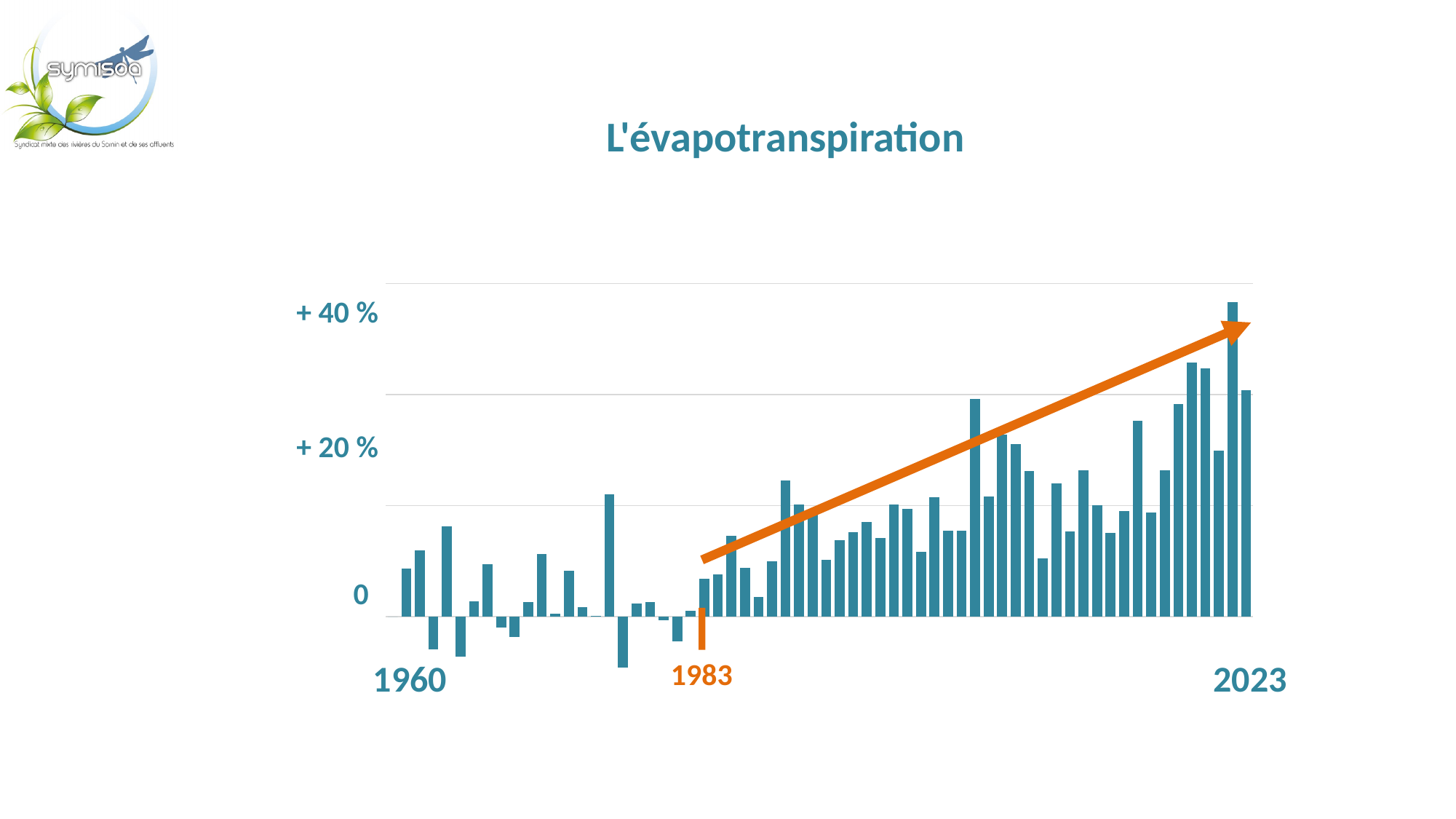
Is the value for 1960 greater or less than + 20 %? less What is the last year shown on the x axis of the chart? 2023 Is the value for 2023 greater or less than + 20 %? greater Which year is marked in orange on the x axis of the chart? 1983 What kind of chart is shown on the slide? Bar chart What is the title of the chart? L'évapotranspiration What is the first year shown on the x axis of the chart? 1960 What is the highest value labelled on the y axis of the chart? + 40 % Which has the larger value, 1960 or 2023? 2023 Do the values generally rise or fall from 1983 to 2023? Rise Is the lowest bar on the chart before or after 1983? Before Is the value for 2023 greater or less than 0? greater